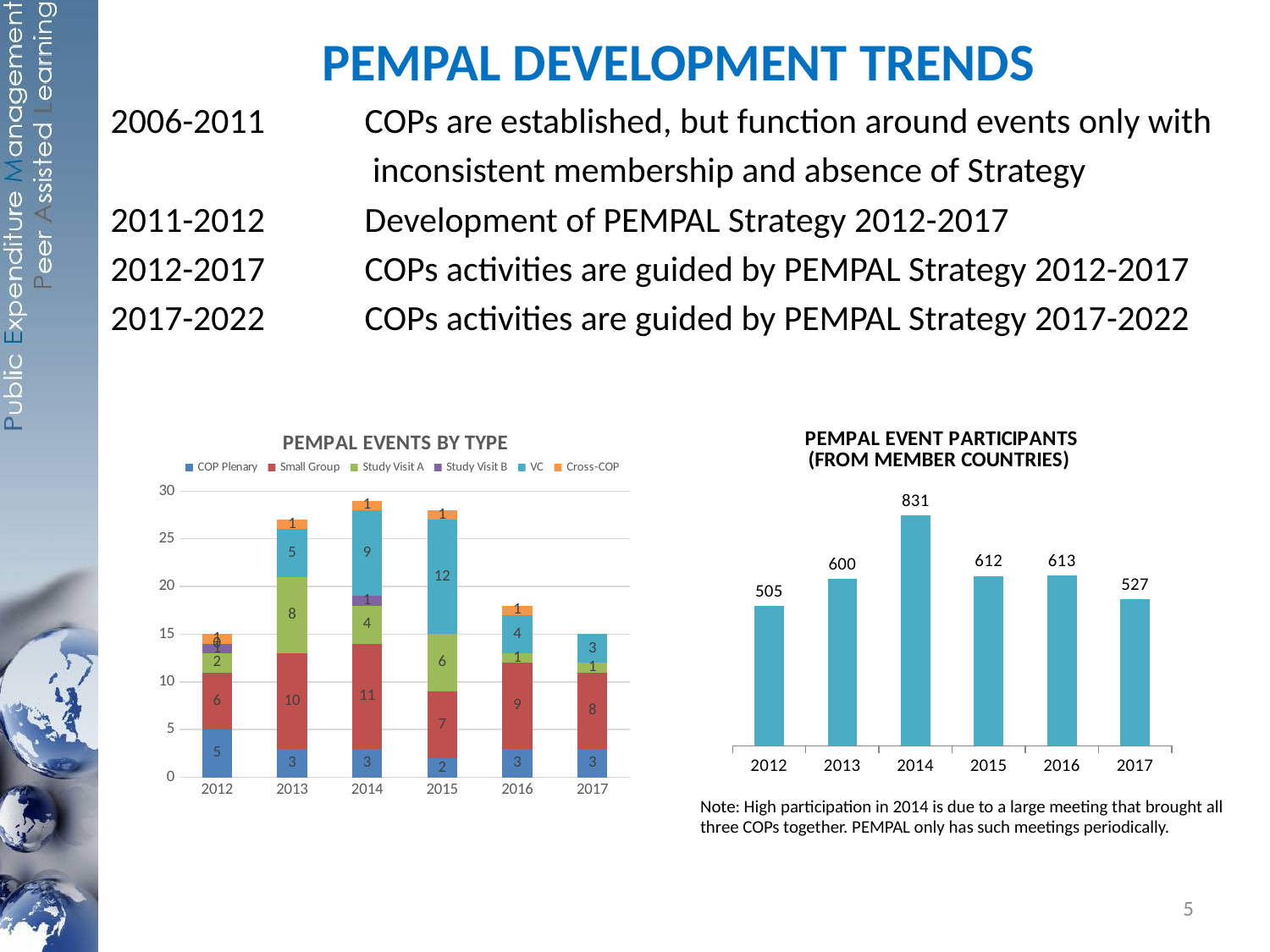
How many series does the legend of the PEMPAL EVENTS BY TYPE chart list? 6 In the PEMPAL EVENTS BY TYPE chart, how many Small Group events were there in 2014? 11 In the PEMPAL EVENT PARTICIPANTS chart, which year had the highest number of participants? 2014 In the PEMPAL EVENT PARTICIPANTS chart, what is the difference between the 2014 and 2013 values? 231 In the PEMPAL EVENT PARTICIPANTS chart, which year had more participants, 2015 or 2017? 2015 What kind of chart is the PEMPAL EVENT PARTICIPANTS chart? Bar chart In the PEMPAL EVENT PARTICIPANTS chart, how many participants were there in 2014? 831 In the PEMPAL EVENTS BY TYPE chart, what is the total number of events in 2013? 27 How many years are shown in the PEMPAL EVENT PARTICIPANTS chart? 6 In the PEMPAL EVENTS BY TYPE chart, how many VC events were there in 2015? 12 In the PEMPAL EVENT PARTICIPANTS chart, do the values rise or fall from 2012 to 2014? Rise In the PEMPAL EVENT PARTICIPANTS chart, which year had the lowest number of participants? 2012